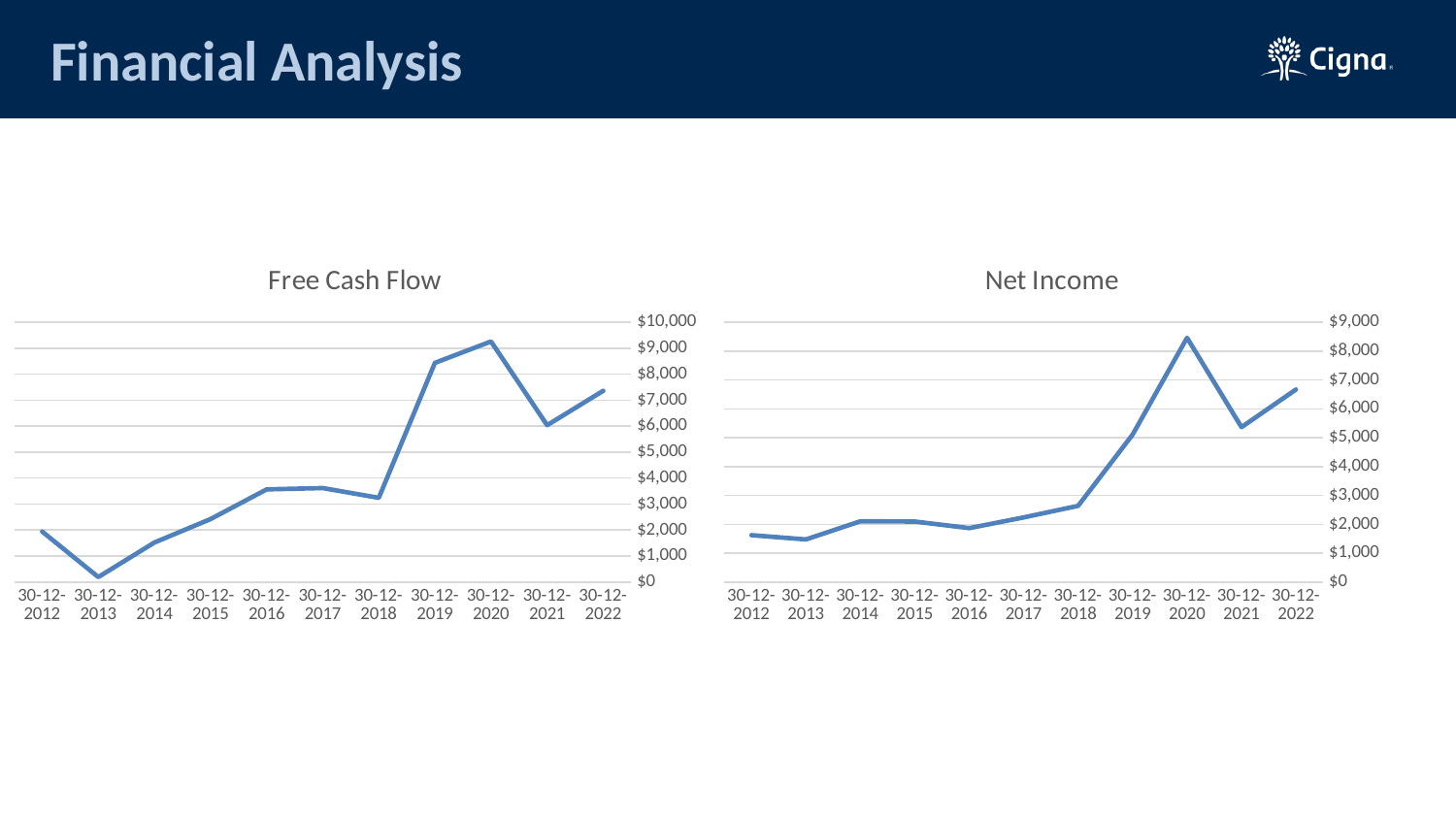
On the Net Income chart, does the value rise or fall between 30-12-2018 and 30-12-2020? rise On the Net Income chart, which is larger, the value for 30-12-2020 or the value for 30-12-2022? 30-12-2020 On the Free Cash Flow chart, which is larger, the value for 30-12-2021 or the value for 30-12-2022? 30-12-2022 On the Free Cash Flow chart, which date has the highest value? 30-12-2020 On the Net Income chart, which date has the highest value? 30-12-2020 How many data points are plotted on the Net Income chart? 11 On the Free Cash Flow chart, is the value for 30-12-2019 greater or less than $8,000? greater On the Free Cash Flow chart, which date has the lowest value? 30-12-2013 On the Free Cash Flow chart, is the value for 30-12-2013 greater or less than $1,000? less What kind of chart is the Free Cash Flow chart? line chart On the Net Income chart, is the value for 30-12-2021 greater or less than $6,000? less What is the title of the chart on the right side of the slide? Net Income